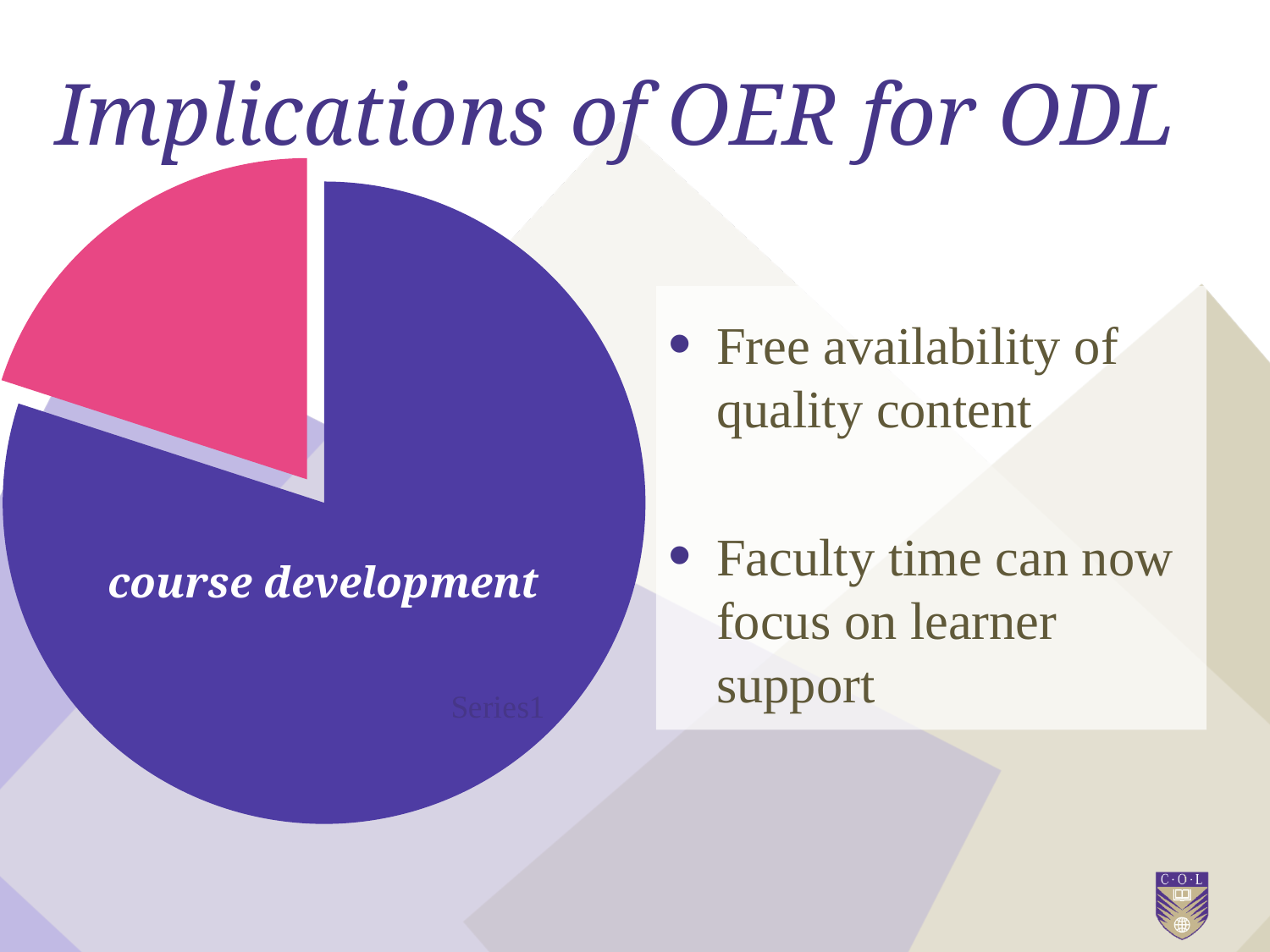
What label is printed on the large purple slice of the pie chart? course development Which slice of the pie chart is the smallest: the purple one or the pink one? The pink one What colour is the smaller, pulled-out slice of the pie chart? Pink Which is larger in the pie chart: the purple slice or the pink slice? The purple slice What kind of chart is shown on the slide? Pie chart How many slices does the pie chart have? 2 Which slice of the pie chart is the largest? course development